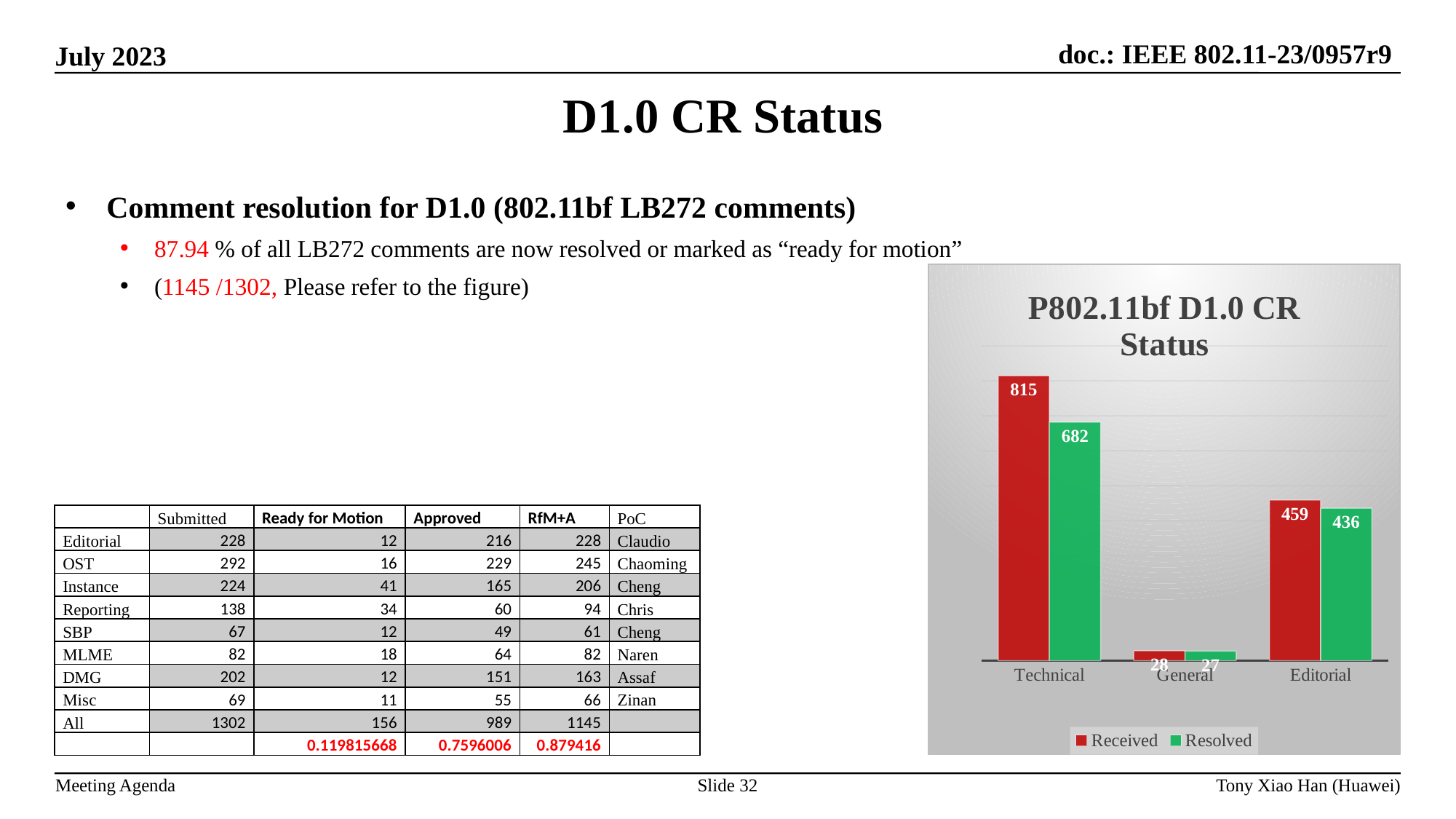
How many series does the legend list? 2 Which category has the lowest Resolved value? General What is the difference between Received and Resolved for Editorial? 23 What is the Received value for Technical? 815 What is the Resolved value for Editorial? 436 What kind of chart is shown? Bar chart Which category has the highest Received value? Technical What is the difference between Received and Resolved for Technical? 133 Which is larger, the Resolved value for Technical or the Received value for Editorial? Resolved value for Technical What is the Resolved value for General? 27 What is the Received value for Editorial? 459 How many categories are shown on the x axis? 3